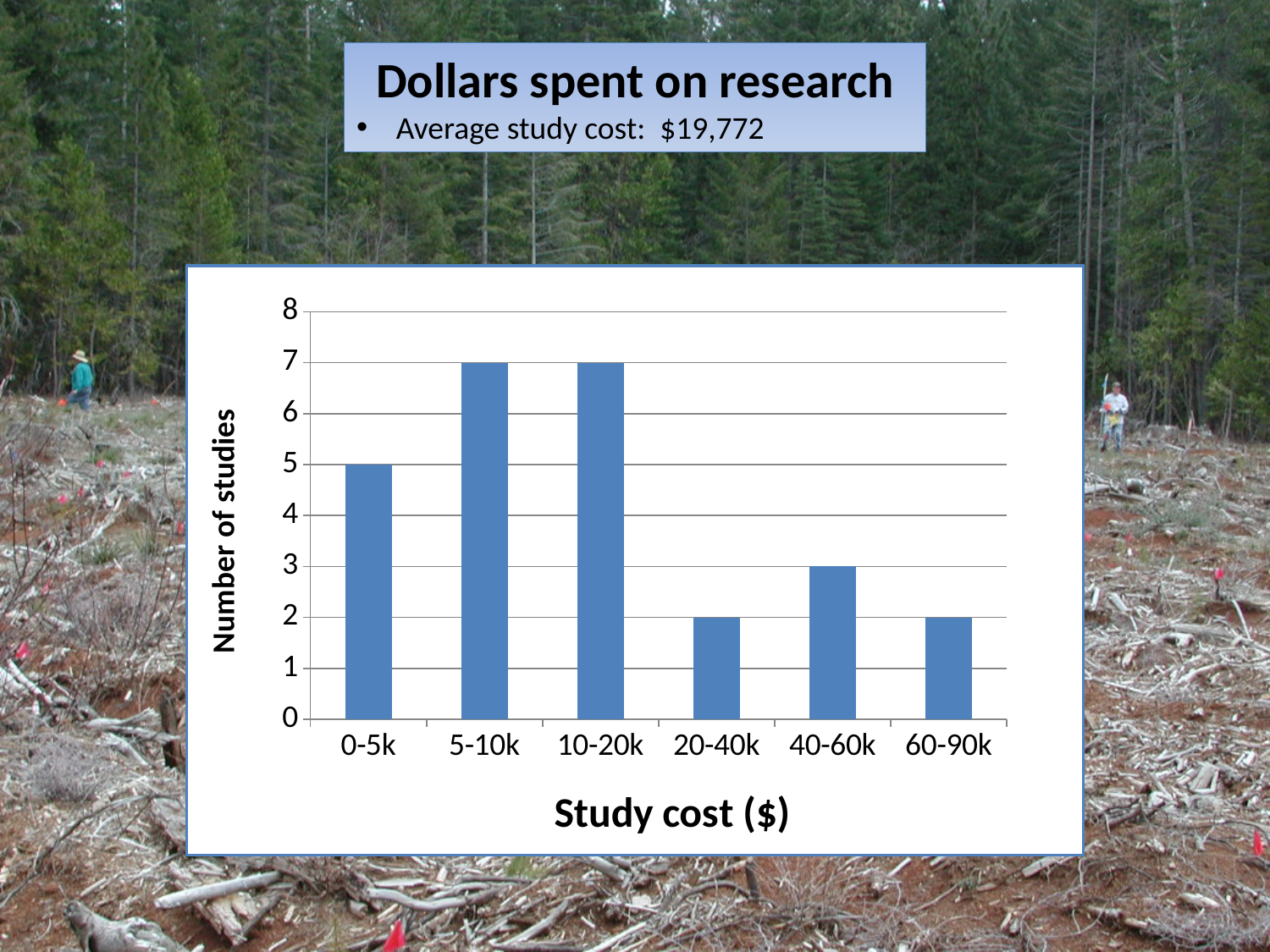
Which has more studies, the 0-5k category or the 40-60k category? 0-5k What is the number of studies for the 0-5k study cost category? 5 Is the number of studies for the 10-20k category greater or less than 4? greater Does the number of studies rise or fall from the 10-20k category to the 20-40k category? fall What is the number of studies for the 60-90k study cost category? 2 How many study cost categories are shown on the x axis? 6 What is the label of the vertical axis of the chart? Number of studies What kind of chart is shown on the slide? bar chart What is the number of studies for the 5-10k study cost category? 7 What is the label of the horizontal axis of the chart? Study cost ($) What is the number of studies for the 40-60k study cost category? 3 What is the difference in number of studies between the 5-10k category and the 20-40k category? 5